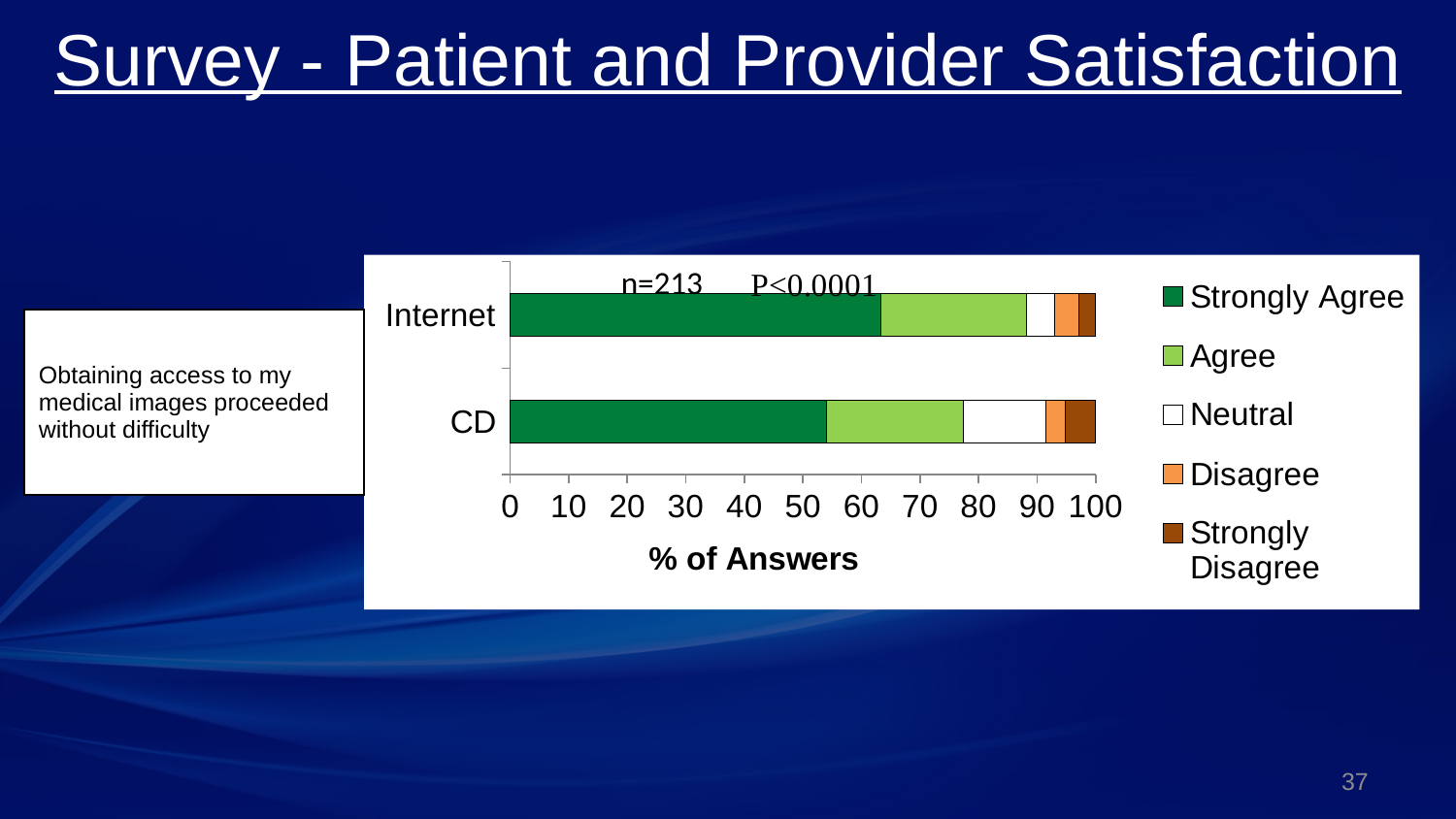
Which category has the larger Strongly Agree segment, Internet or CD? Internet Which category has the larger Neutral segment, Internet or CD? CD What kind of chart is shown on the slide? Stacked bar chart Is the Strongly Agree value for CD greater or less than 50? greater How many categories are plotted on the y axis of the chart? 2 What value does the full stacked bar for Internet reach on the x axis? 100 How many series does the chart's legend list? 5 What sample size (n) is printed on the chart? n=213 Is the Strongly Agree value for CD greater or less than 60? less What is the title of the x axis of the chart? % of Answers Is the Strongly Agree value for Internet greater or less than 50? greater Which category has the larger Strongly Disagree segment, Internet or CD? CD